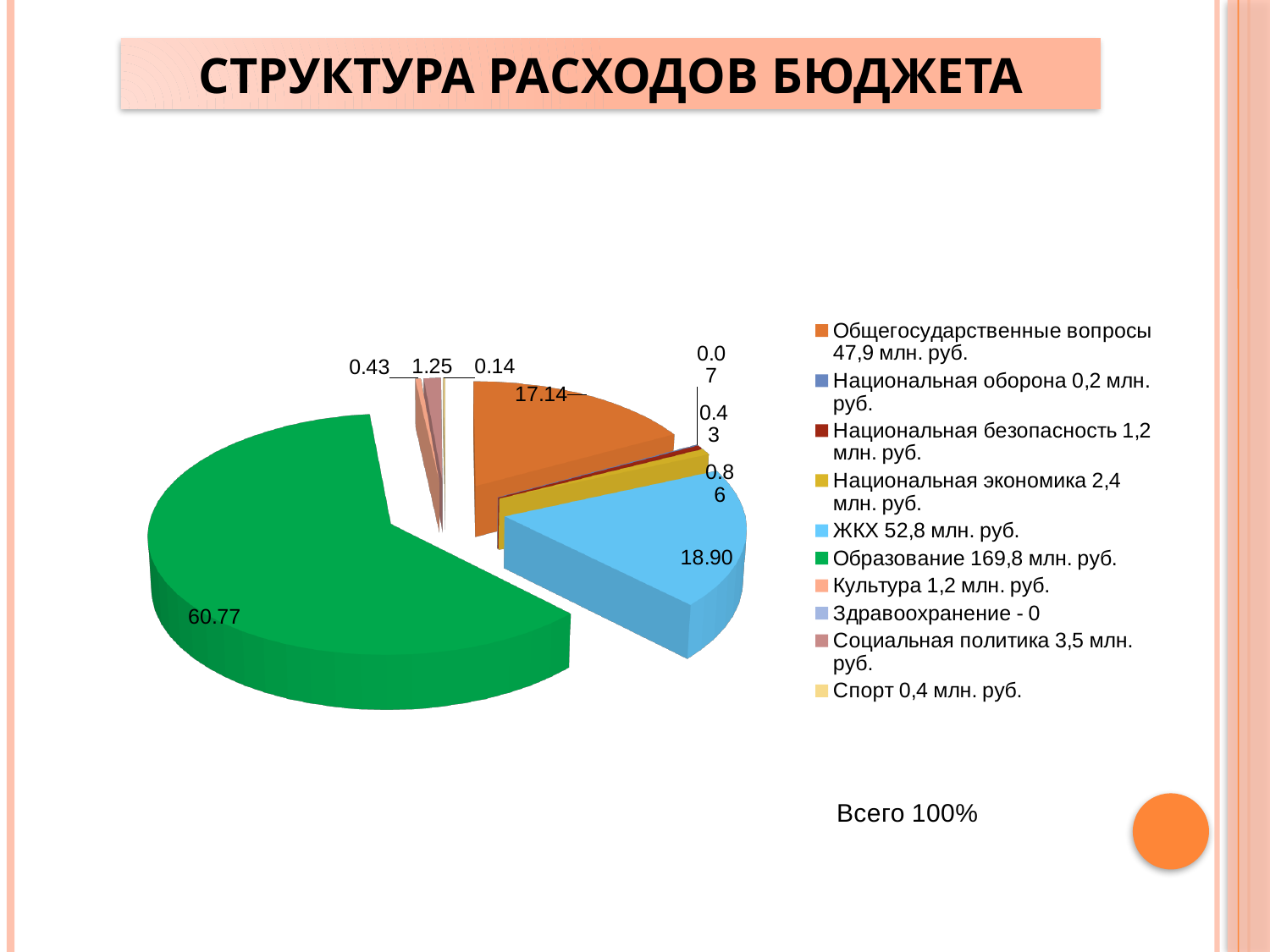
Which slice is larger, ЖКХ or Общегосударственные вопросы? ЖКХ According to the legend, how much is spent on ЖКХ? 52,8 млн. руб. What kind of chart is shown on the slide? pie chart What is the difference between the Образование label (60.77) and the ЖКХ label (18.90)? 41.87 According to the legend, how much is spent on Образование? 169,8 млн. руб. What is the title of the slide's chart? Всего 100% What value is labelled on the ЖКХ slice? 18.90 How many categories does the legend list? 10 What value is labelled on the Образование slice? 60.77 Which category has the largest slice of the pie? Образование What is the difference between the ЖКХ label (18.90) and the Общегосударственные вопросы label (17.14)? 1.76 What value is labelled on the Общегосударственные вопросы slice? 17.14